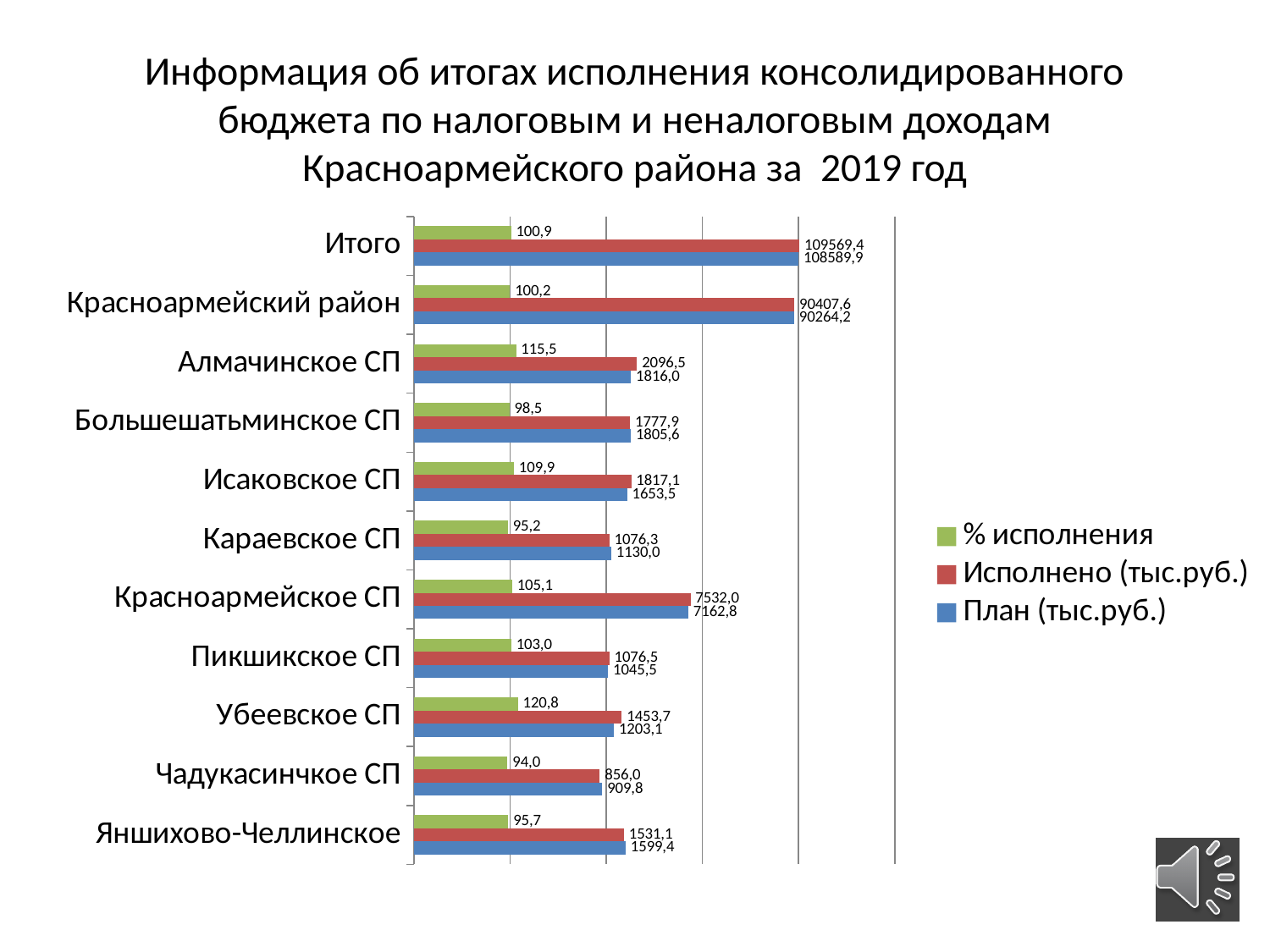
What kind of chart is shown on the slide? Bar chart What is the difference between Исполнено (тыс.руб.) and План (тыс.руб.) for Убеевское СП? 250,6 How many series does the legend list? 3 Which category has the highest % исполнения? Убеевское СП What is the План (тыс.руб.) value for Итого? 108589,9 What is the % исполнения value for Исаковское СП? 109,9 What is the difference between Исполнено (тыс.руб.) and План (тыс.руб.) for Алмачинское СП? 280,5 What is the value of Исполнено (тыс.руб.) for Алмачинское СП? 2096,5 How many categories are shown on the chart? 11 For Караевское СП, which is larger: Исполнено (тыс.руб.) or План (тыс.руб.)? План (тыс.руб.) Which category has the lowest % исполнения? Чадукасинчкое СП Which colour represents the План (тыс.руб.) series? Blue